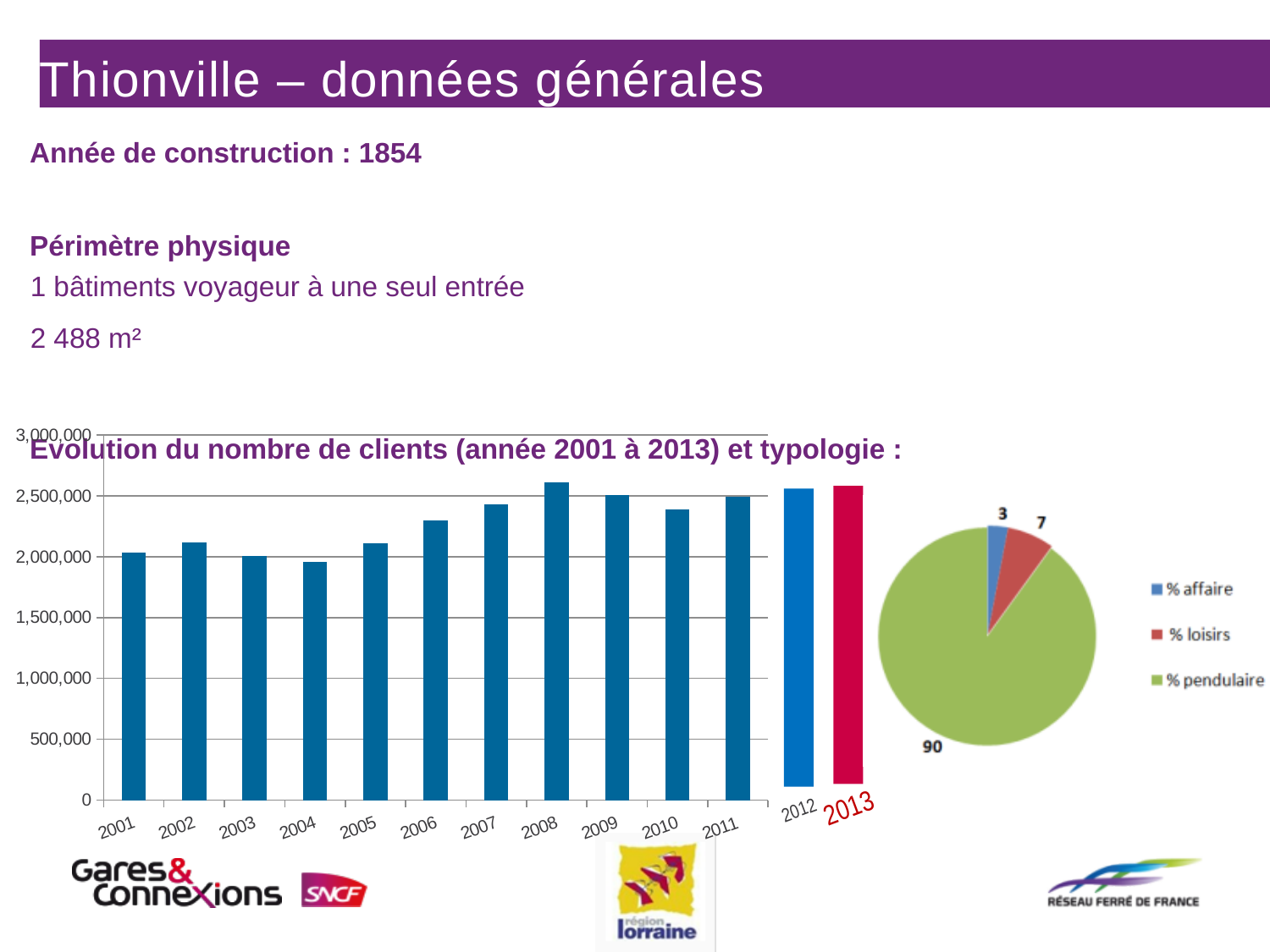
In the left bar chart, how many years are shown on the x axis? 13 In the left bar chart, is the value for 2008 greater or less than 2,500,000? greater In the left bar chart, which year has the larger value, 2006 or 2008? 2008 In the left bar chart, which year has the larger value, 2004 or 2007? 2007 What kind of chart is the right chart showing the client typology? pie chart In the right pie chart, what is the value for % pendulaire? 90 In the right pie chart, which category has the smallest slice? % affaire In the left bar chart, is the value for 2010 greater or less than 2,500,000? less In the right pie chart, what is the difference between the values for % pendulaire and % loisirs? 83 What kind of chart is the left chart showing the number of clients from 2001 to 2013? bar chart In the right pie chart, what is the value for % loisirs? 7 In the left bar chart, is the value for 2004 greater or less than 2,000,000? less